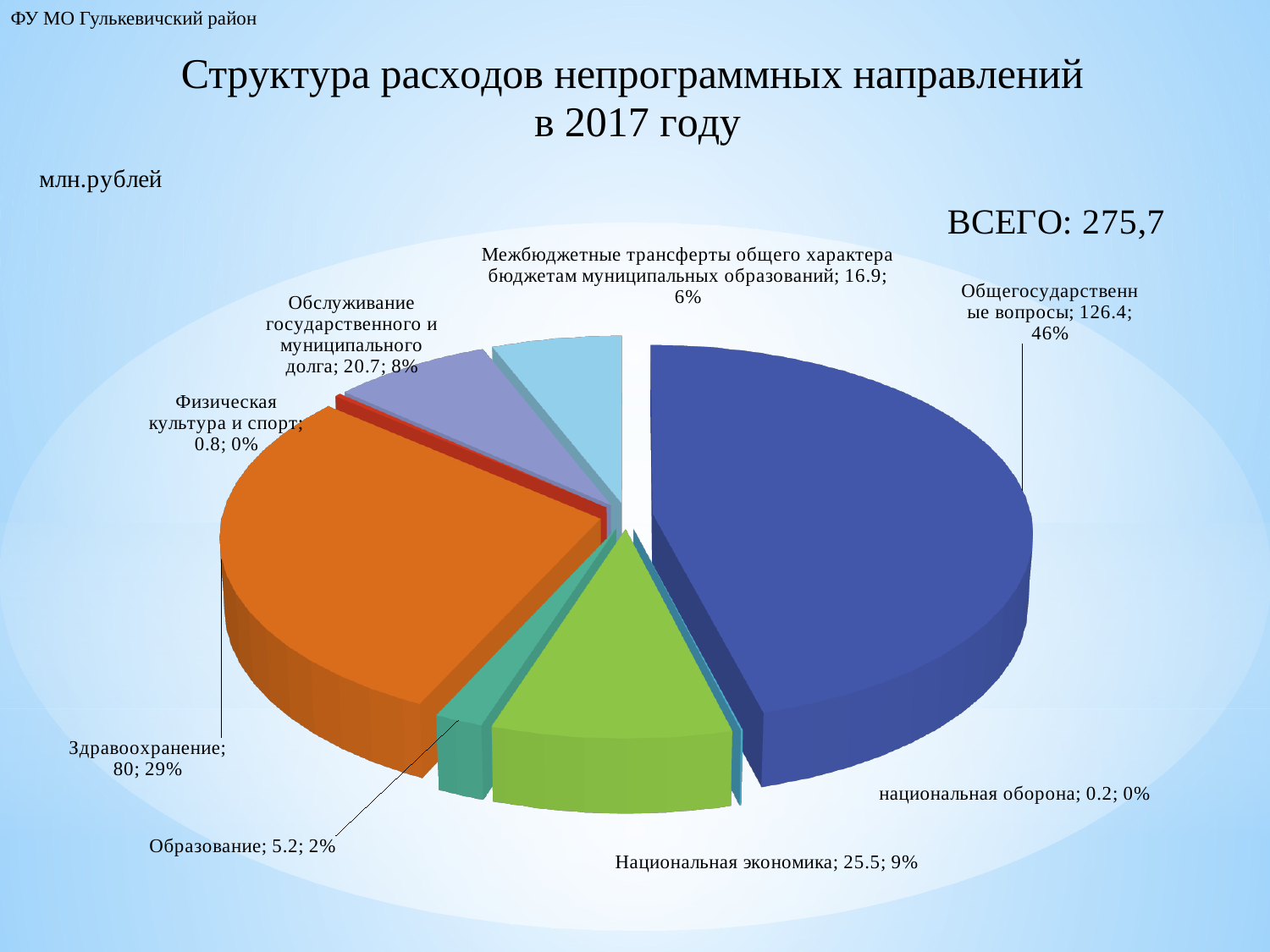
How many categories (slices) does the pie chart have? 8 What is the value for Национальная экономика? 25.5 What is the difference between the values for Общегосударственные вопросы and Здравоохранение? 46.4 What share of the pie does Национальная экономика represent? 9% What kind of chart is shown on the slide? pie chart Which category has the largest value? Общегосударственные вопросы What is the value for Общегосударственные вопросы? 126.4 Which is larger, the value for Образование or the value for Межбюджетные трансферты общего характера бюджетам муниципальных образований? Межбюджетные трансферты общего характера бюджетам муниципальных образований What total (ВСЕГО) is stated on the slide? 275,7 What is the value for Обслуживание государственного и муниципального долга? 20.7 Which category has the smallest value? национальная оборона What share of the pie does Здравоохранение represent? 29%